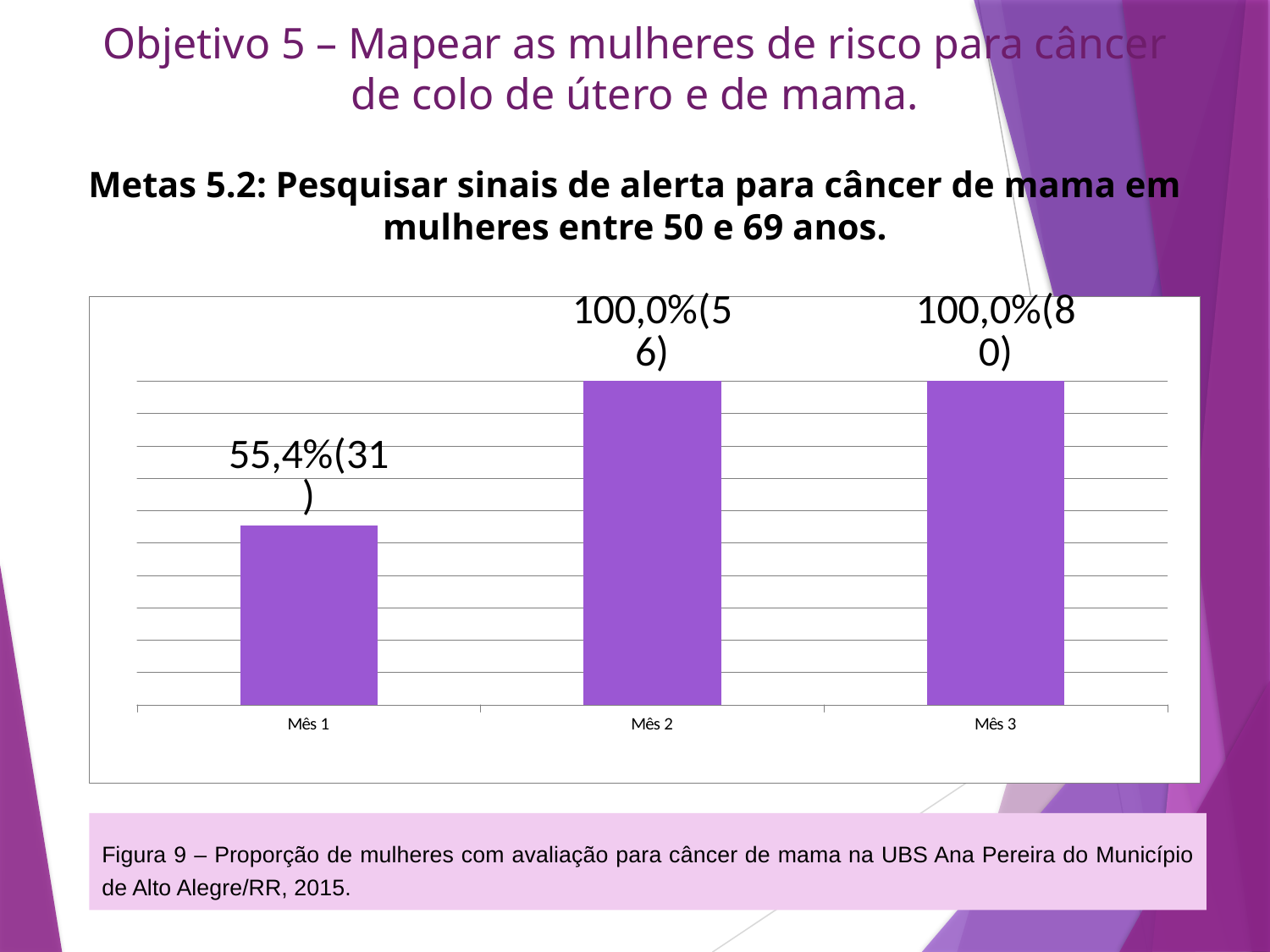
Do the values rise or fall from Mês 1 to Mês 2? Rise What is the data label shown for Mês 3? 100,0%(80) What is the data label shown for Mês 2? 100,0%(56) What is the figure number given in the caption below the chart? Figura 9 What is the difference in percentage between Mês 2 and Mês 1? 44,6% Which month has the lowest value? Mês 1 Which has a larger value, Mês 1 or Mês 3? Mês 3 What percentage is shown for Mês 1? 55,4% Which months share the highest percentage value? Mês 2 and Mês 3 How many categories are shown on the x axis? 3 What kind of chart is shown on the slide? Bar chart What is the data label shown for Mês 1? 55,4%(31)